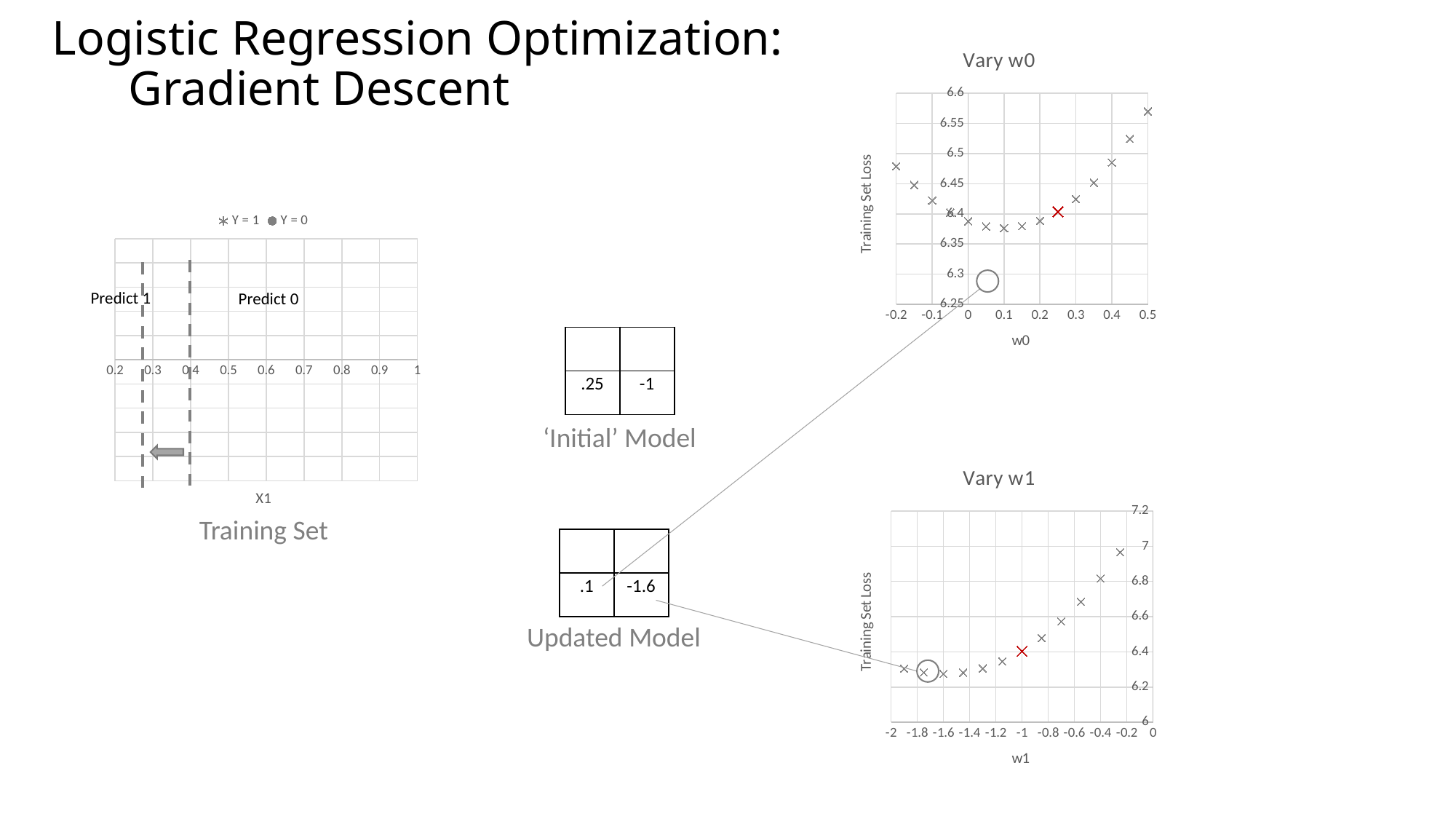
In the 'Vary w1' chart, does the training set loss rise or fall as w1 increases from -1.4 to -0.2? rise In the 'Vary w0' chart, is the training set loss at w0 = 0.1 greater or less than 6.4? less In the 'Vary w0' chart, is the training set loss at w0 = 0.5 greater or less than 6.5? greater In the 'Vary w0' chart, which has the larger training set loss: w0 = -0.2 or w0 = 0.5? w0 = 0.5 What kind of chart is the 'Vary w0' chart? scatter chart In the 'Vary w0' chart, at which w0 value is the training set loss highest? 0.5 What is the x-axis title of the 'Vary w0' chart? w0 In the 'Vary w1' chart, is the training set loss at w1 = -1 greater or less than 6.6? less How many series does the legend of the 'Training Set' chart list? 2 In the 'Vary w1' chart, which has the larger training set loss: w1 = -1.8 or w1 = -0.4? w1 = -0.4